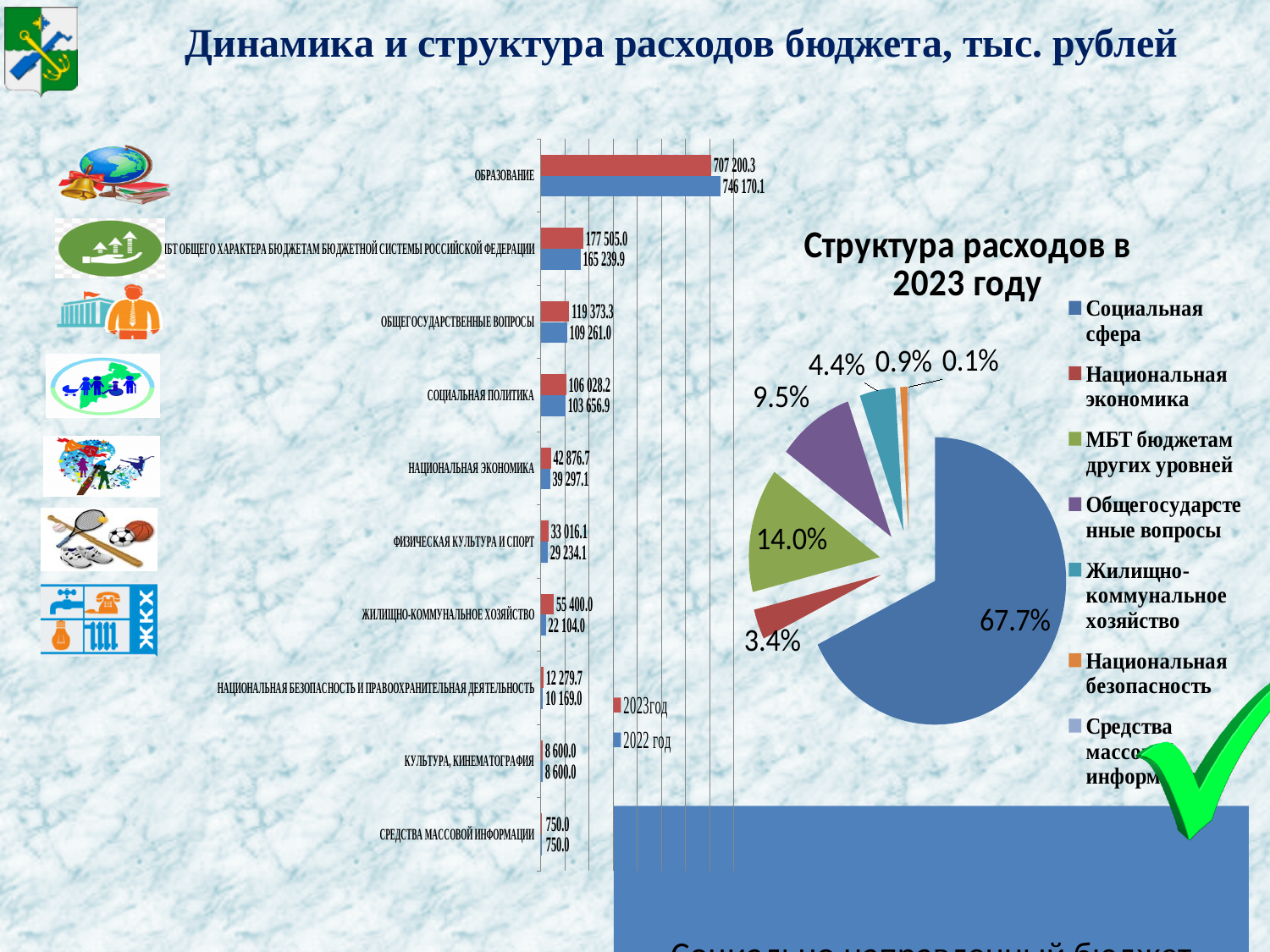
In the pie chart 'Структура расходов в 2023 году', what share does МБТ бюджетам других уровней have? 14.0% In the bar chart on the left, which category has the lowest value for 2023год? СРЕДСТВА МАССОВОЙ ИНФОРМАЦИИ In the bar chart on the left, what is the difference between the 2023год and 2022 год values for ЖИЛИЩНО-КОММУНАЛЬНОЕ ХОЗЯЙСТВО? 33 296.0 In the bar chart on the left, what is the 2023год value for ОБРАЗОВАНИЕ? 707 200.3 How many series does the legend of the bar chart on the left list? 2 What kind of chart is the chart on the left of the slide? Bar chart In the pie chart 'Структура расходов в 2023 году', what share does Социальная сфера have? 67.7% How many categories are shown in the bar chart on the left? 10 In the bar chart on the left, what is the 2022 год value for ЖИЛИЩНО-КОММУНАЛЬНОЕ ХОЗЯЙСТВО? 22 104.0 In the bar chart on the left, which category has the highest value for 2022 год? ОБРАЗОВАНИЕ In the bar chart on the left, which is larger for ОБРАЗОВАНИЕ: the 2023год value or the 2022 год value? 2022 год In the pie chart 'Структура расходов в 2023 году', which slice is the smallest? Средства массовой информации